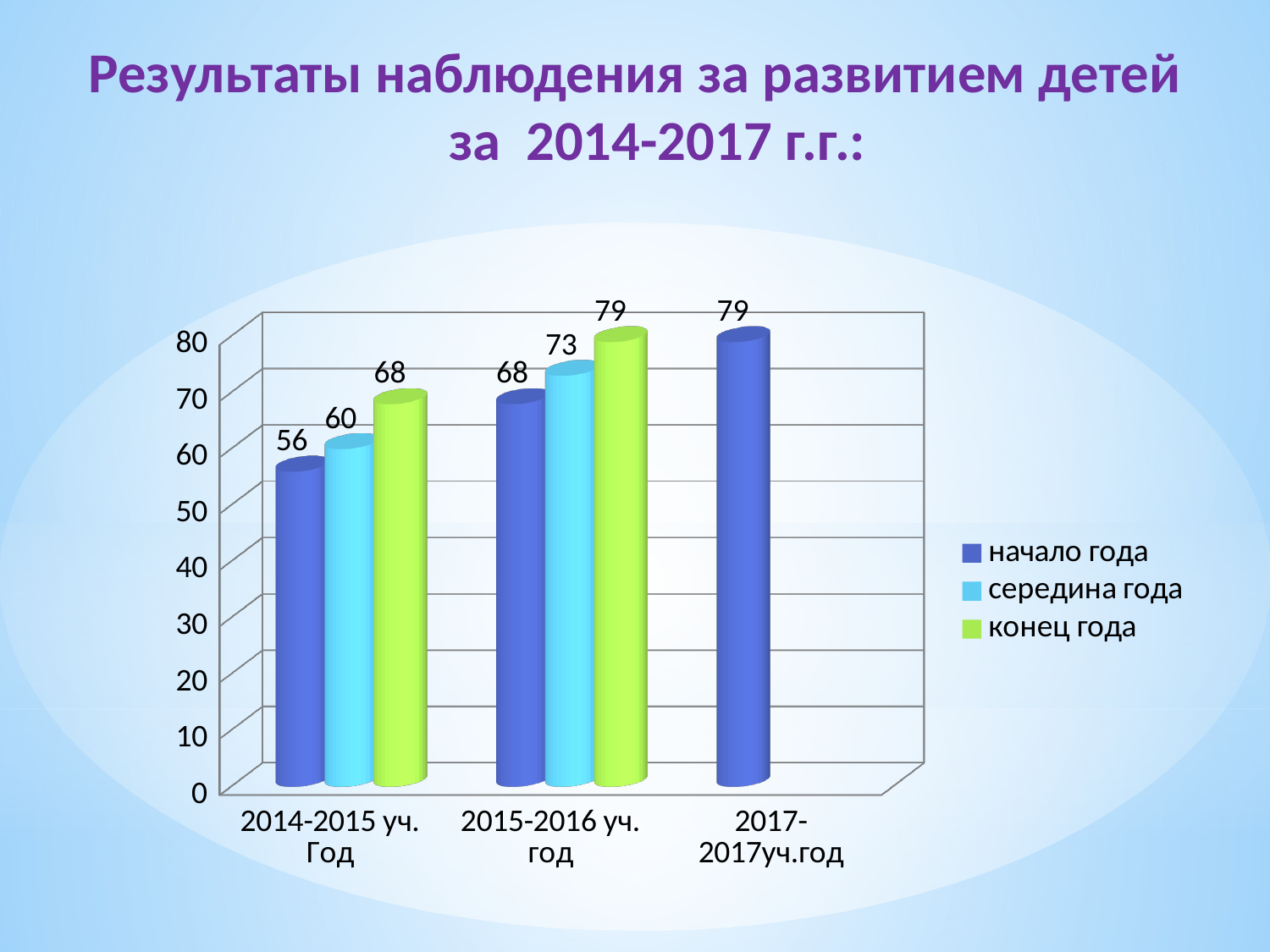
Which series has the highest value in the 2014-2015 уч. Год category? конец года What is the value for "конец года" in the 2015-2016 уч. год category? 79 What is the value for "начало года" in the 2014-2015 уч. Год category? 56 Which category has the lowest value for "начало года"? 2014-2015 уч. Год What is the difference between the "конец года" and "начало года" values in the 2015-2016 уч. год category? 11 How many series does the legend list? 3 What is the difference between the "середина года" values for 2015-2016 уч. год and 2014-2015 уч. Год? 13 What is the value for "середина года" in the 2015-2016 уч. год category? 73 What kind of chart is shown on the slide? Bar chart Which is larger: "конец года" for 2014-2015 уч. Год or "начало года" for 2015-2016 уч. год? They are equal (68) What is the value shown for the 2017-2017уч.год category? 79 Do the "начало года" values rise or fall from 2014-2015 уч. Год to 2017-2017уч.год? Rise